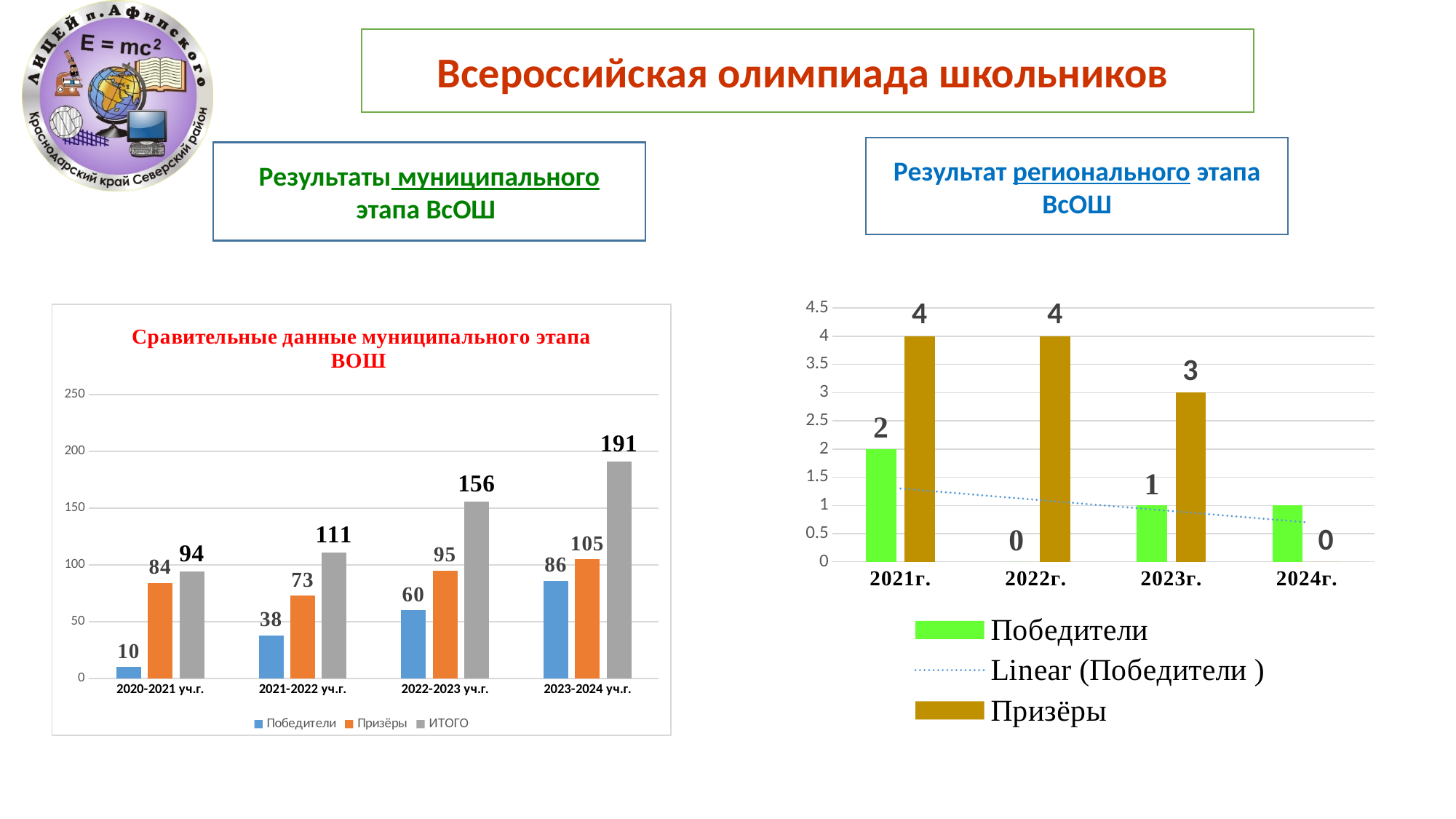
In the right chart (regional stage results), which is larger for 2022г.: Победители or Призёры? Призёры In the left chart 'Сравительные данные муниципального этапа ВОШ', what is the value of ИТОГО for 2023-2024 уч.г.? 191 In the left chart 'Сравительные данные муниципального этапа ВОШ', does the Победители series rise or fall across the academic years? rise In the left chart 'Сравительные данные муниципального этапа ВОШ', what is the difference between Призёры and Победители for 2022-2023 уч.г.? 35 In the right chart (regional stage results), what is the value of Призёры for 2023г.? 3 In the left chart 'Сравительные данные муниципального этапа ВОШ', what is the value of Победители for 2020-2021 уч.г.? 10 What kind of chart is the left chart 'Сравительные данные муниципального этапа ВОШ'? bar chart In the left chart 'Сравительные данные муниципального этапа ВОШ', how many series does the legend list? 3 In the right chart (regional stage results), what is the value of Победители for 2021г.? 2 In the right chart (regional stage results), how many year categories are shown on the x axis? 4 In the left chart 'Сравительные данные муниципального этапа ВОШ', which academic year has the lowest ИТОГО value? 2020-2021 уч.г. In the left chart 'Сравительные данные муниципального этапа ВОШ', what is the value of Призёры for 2021-2022 уч.г.? 73